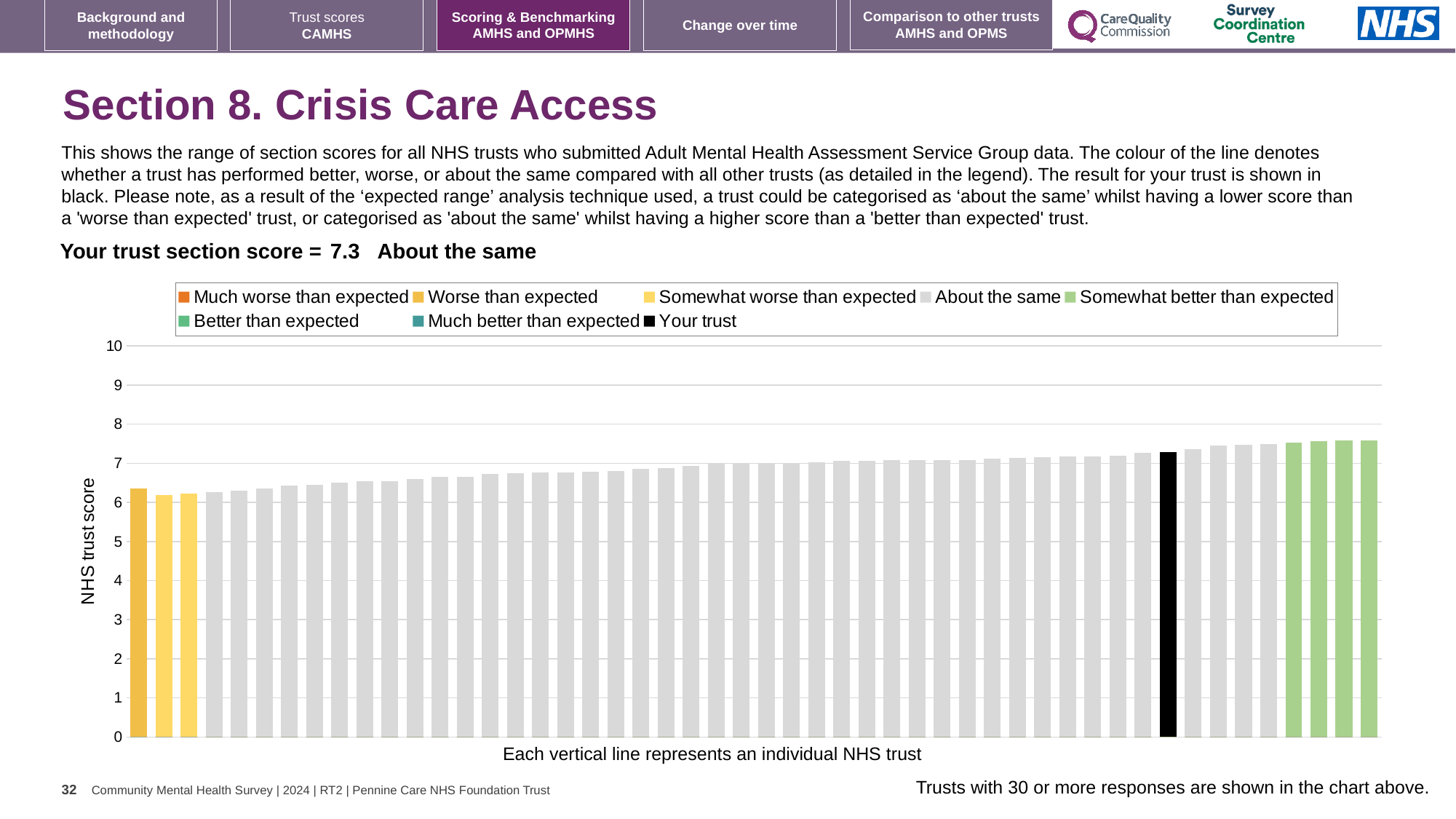
What is the label on the vertical axis of the chart? NHS trust score Is the value of the black 'Your trust' bar greater or less than 7? greater What kind of chart is shown on the slide? Bar chart How many bars are coloured green (somewhat better than expected) in the chart? 4 Is the value of the shortest bar in the chart greater or less than 6? greater Is the black 'Your trust' bar higher or lower than the green bars at the right of the chart? lower Which benchmarking category is your trust placed in for Crisis Care Access? About the same Is the value of the tallest bar in the chart greater or less than 8? less What colour is the bar representing your trust? Black How many entries does the chart legend list? 8 What is the section score for your trust shown on the slide? 7.3 Do the bar values rise or fall from left to right across the chart? rise